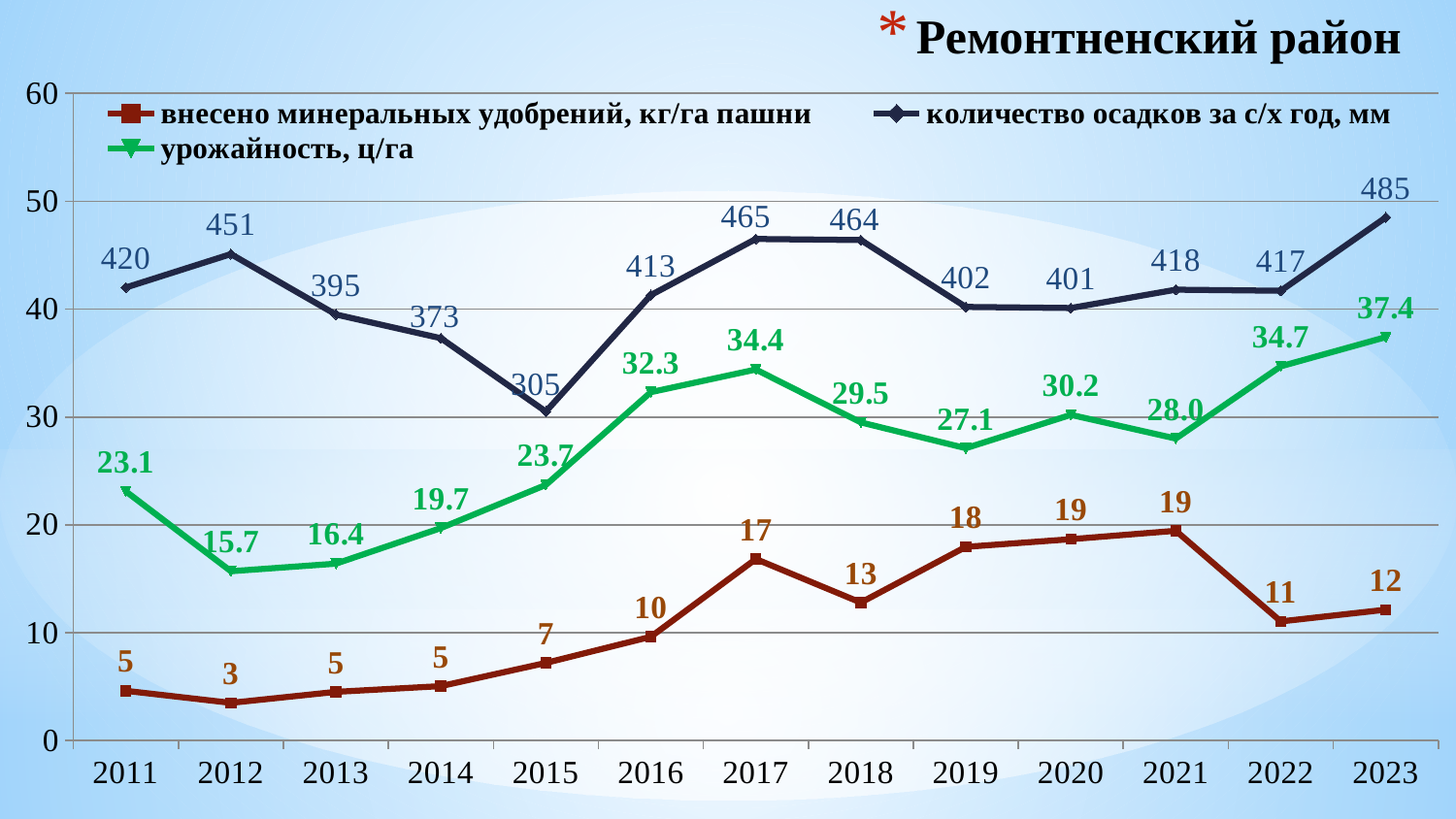
What is the title of the chart? Ремонтненский район Which is larger: 'внесено минеральных удобрений, кг/га пашни' in 2017 or in 2018? 2017 What is the value of 'урожайность, ц/га' in 2017? 34.4 In which year is 'урожайность, ц/га' lowest? 2012 Does 'внесено минеральных удобрений, кг/га пашни' rise or fall from 2011 to 2017? rise In which year is 'количество осадков за с/х год, мм' highest? 2023 What is the difference between the 'урожайность, ц/га' values in 2023 and 2011? 14.3 How many series does the legend list? 3 What is the value of 'количество осадков за с/х год, мм' in 2015? 305 What is the value of 'внесено минеральных удобрений, кг/га пашни' in 2021? 19 How many years are shown on the x axis? 13 What type of chart is shown on the slide? line chart